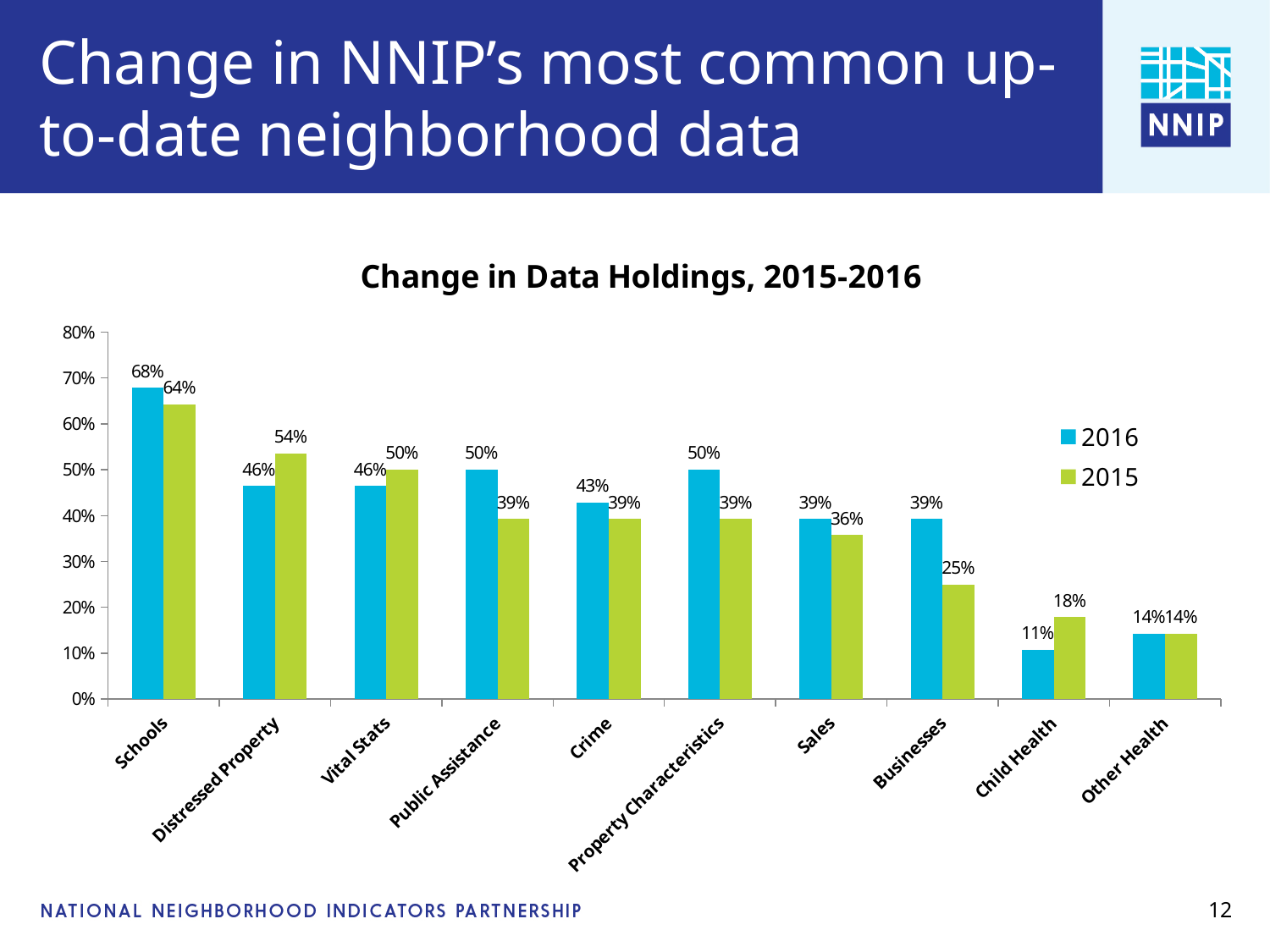
What is the 2015 value for Distressed Property? 54% Which is larger for Vital Stats, the 2016 value or the 2015 value? 2015 How many series does the legend list? 2 Which category has the lowest 2015 value? Other Health Which category has the highest 2016 value? Schools What is the 2016 value for Child Health? 11% How many categories are shown on the x axis? 10 What is the difference between the 2016 and 2015 values for Businesses? 14% What is the title of the chart? Change in Data Holdings, 2015-2016 What is the 2016 value for Schools? 68% What kind of chart is shown? bar chart Is the 2016 value for Property Characteristics greater or less than 40%? greater